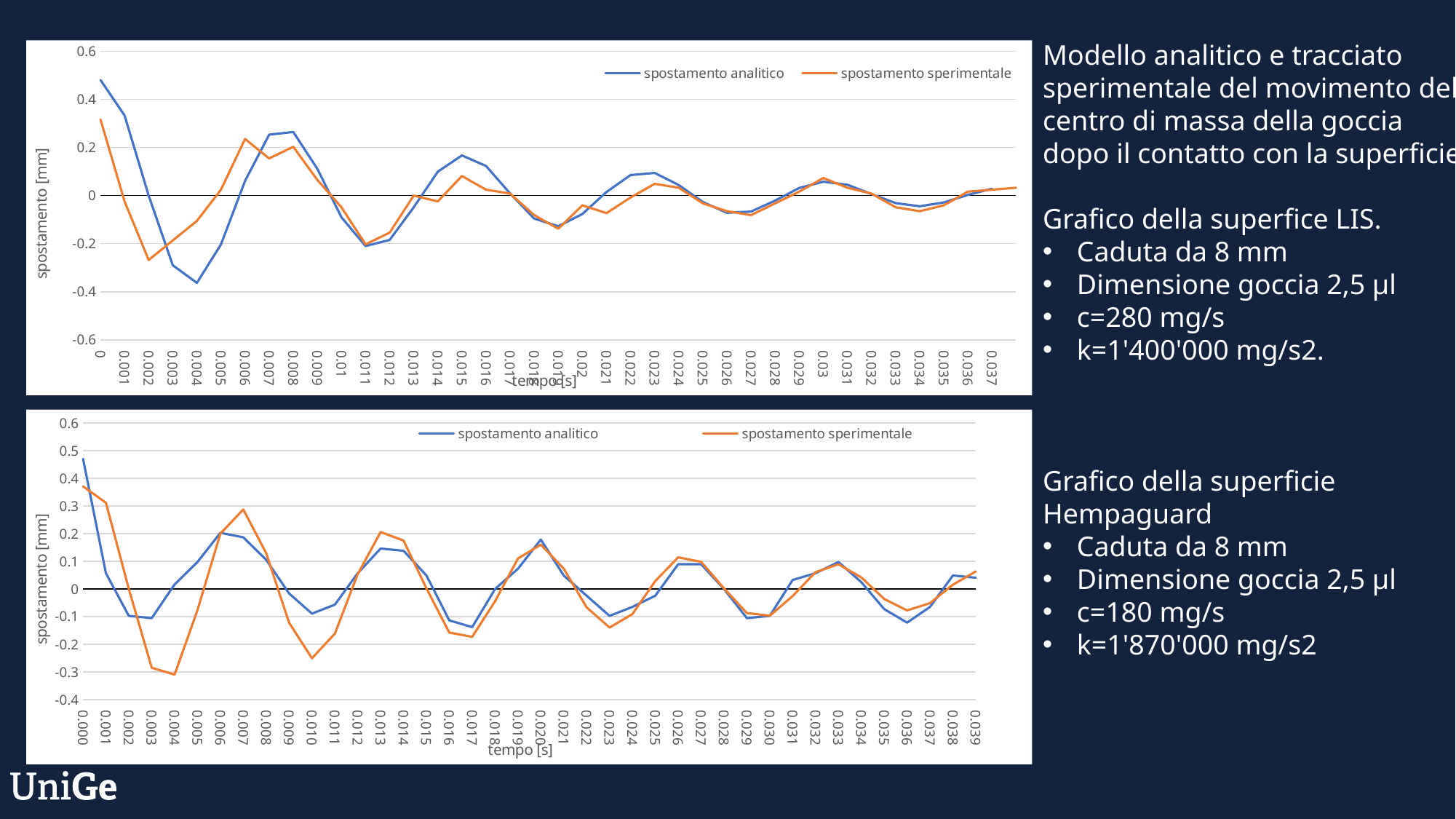
In the top chart, is the value of spostamento analitico at time 0 greater or less than 0.4? greater In the bottom chart, does the amplitude of the oscillations increase or decrease as time goes on? decrease In the bottom chart, is the value of spostamento sperimentale at time 0.004 greater or less than -0.2? less In the bottom chart, is the value of spostamento analitico at time 0.000 greater or less than 0.4? greater What type of chart is the top chart? line chart In the top chart, at which time does spostamento analitico reach its lowest value? 0.004 In the top chart, at time 0, which series has the larger value: spostamento analitico or spostamento sperimentale? spostamento analitico How many series does the legend of the bottom chart list? 2 What is the y-axis label of the bottom chart? spostamento [mm] In the bottom chart, at time 0.004, which series has the larger value: spostamento analitico or spostamento sperimentale? spostamento analitico What are the two series named in the legend of the top chart? spostamento analitico, spostamento sperimentale